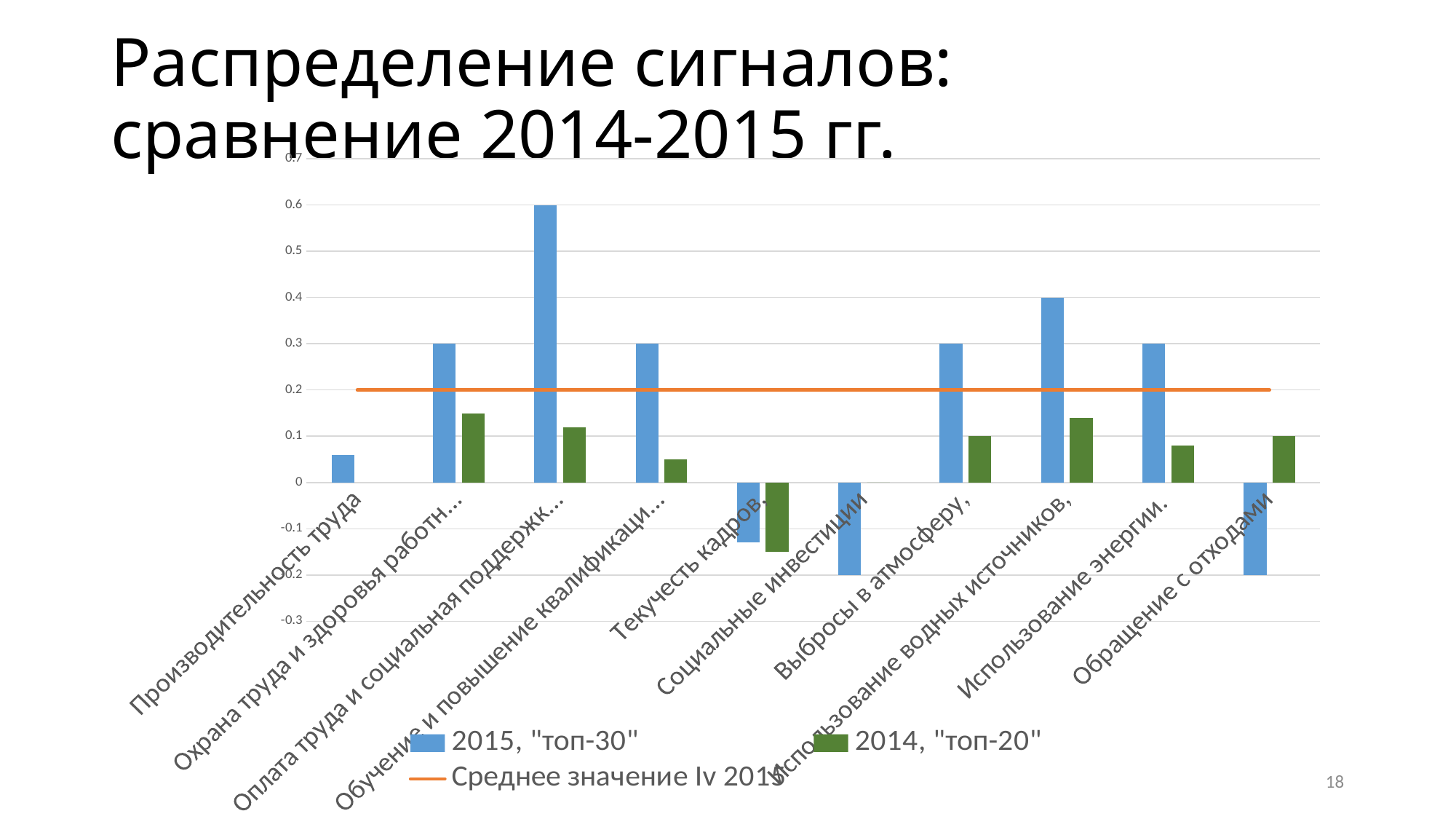
What kind of chart is shown on the slide? combination bar and line chart What is the 2015, "топ-30" value for Оплата труда и социальная поддержк...? 0.6 Is the 2015, "топ-30" value for Производительность труда greater or less than 0.1? less Is the 2014, "топ-20" value for Охрана труда и здоровья работн... greater or less than 0.1? greater What is the difference between the 2015, "топ-30" values for Оплата труда и социальная поддержк... and Использование водных источников? 0.2 For Охрана труда и здоровья работн..., which series has the larger value: 2015, "топ-30" or 2014, "топ-20"? 2015, "топ-30" What is the 2015, "топ-30" value for Использование водных источников? 0.4 Which category has the lowest value for the 2014, "топ-20" series? Текучесть кадров At what value does the Среднее значение Iv 2015 line sit? 0.2 How many entries does the legend list? 3 Which category has the highest value for the 2015, "топ-30" series? Оплата труда и социальная поддержк... How many categories are shown on the x axis? 10